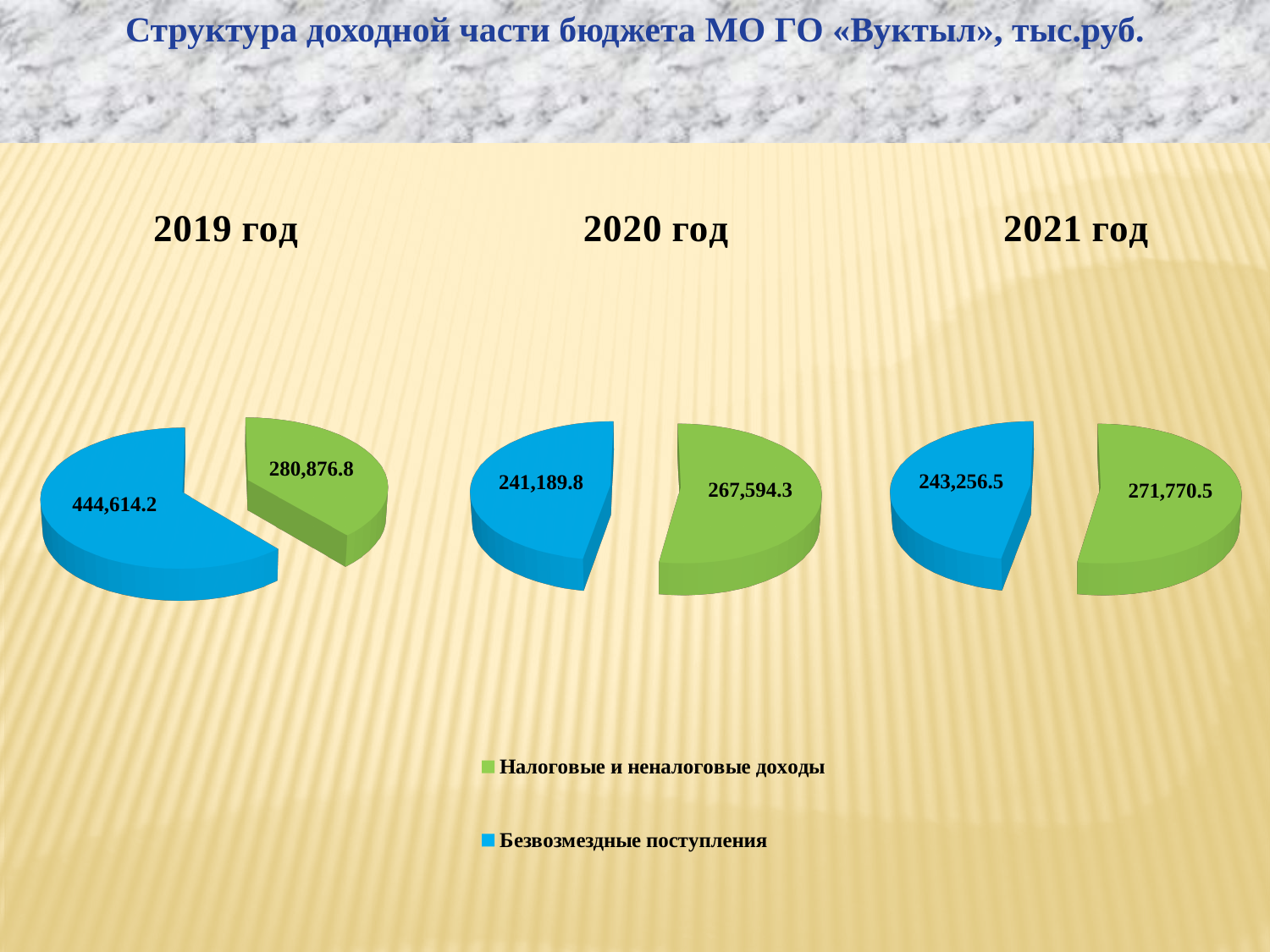
How many pie charts are shown on the slide? 3 In the 2020 год pie chart, what is the value for Налоговые и неналоговые доходы? 267,594.3 In the 2019 год pie chart, what is the difference between Безвозмездные поступления and Налоговые и неналоговые доходы? 163,737.4 In the 2019 год pie chart, what is the value for Налоговые и неналоговые доходы? 280,876.8 In the 2019 год pie chart, which category has the larger value? Безвозмездные поступления In the 2021 год pie chart, which category has the smaller value? Безвозмездные поступления What type of chart is used for each year on this slide? Pie chart In the 2019 год pie chart, what is the value for Безвозмездные поступления? 444,614.2 In the 2021 год pie chart, what is the value for Безвозмездные поступления? 243,256.5 In the 2020 год pie chart, which is larger: Налоговые и неналоговые доходы or Безвозмездные поступления? Налоговые и неналоговые доходы How many categories does the legend list? 2 In the 2021 год pie chart, what is the difference between Налоговые и неналоговые доходы and Безвозмездные поступления? 28,514.0